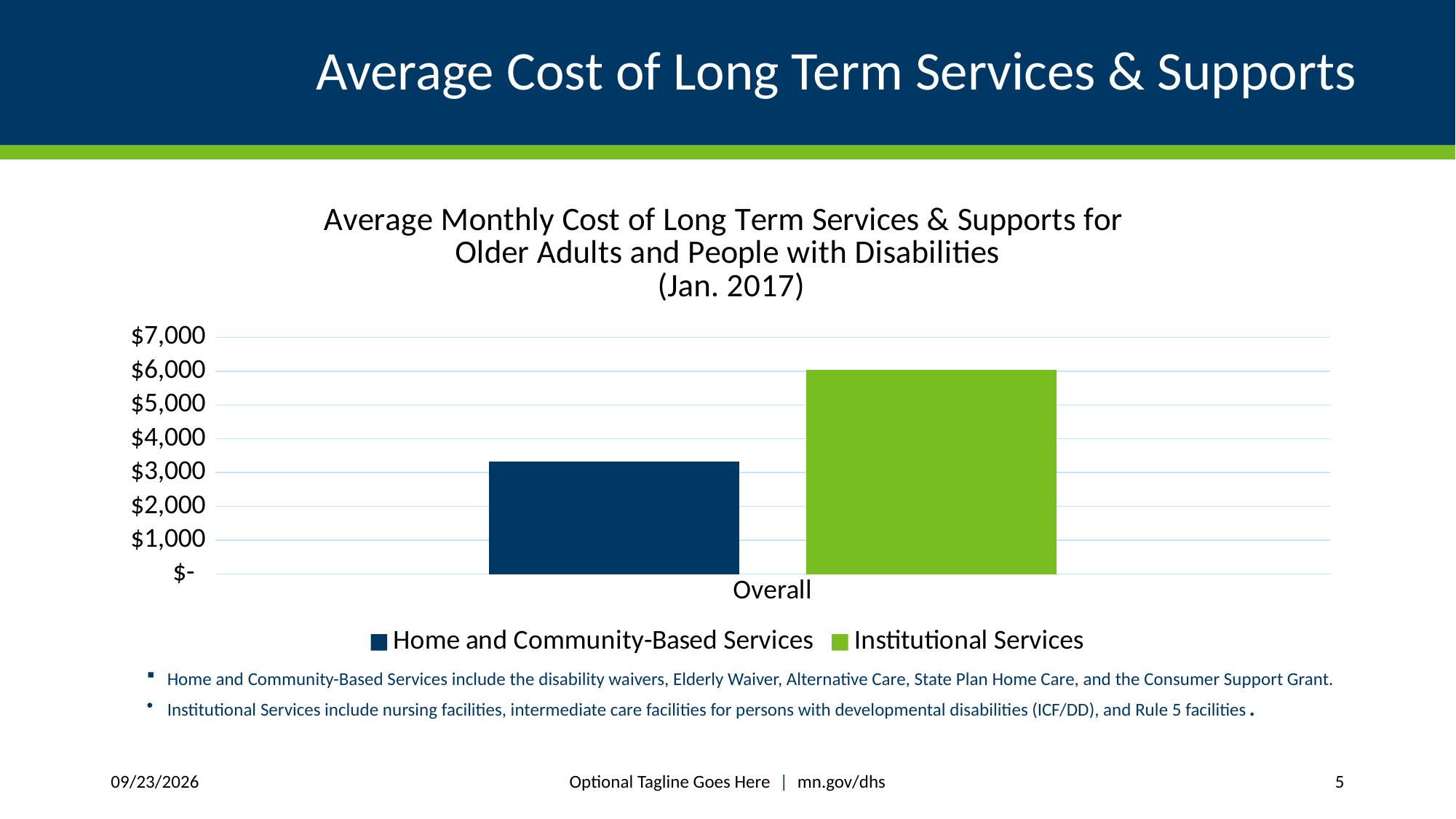
Is the value for Home and Community-Based Services greater or less than $3,000? greater Is the value for Institutional Services greater or less than $5,000? greater How many series does the chart legend list? 2 What is the category label on the x axis of the chart? Overall Is the value for Home and Community-Based Services greater or less than $4,000? less Which series is shown in green in the chart? Institutional Services How many categories are shown on the x axis of the chart? 1 What kind of chart is shown on the slide? bar chart Which series has the lower bar in the chart? Home and Community-Based Services Is the bar for Home and Community-Based Services larger or smaller than the bar for Institutional Services? smaller Which series has the higher bar in the chart? Institutional Services